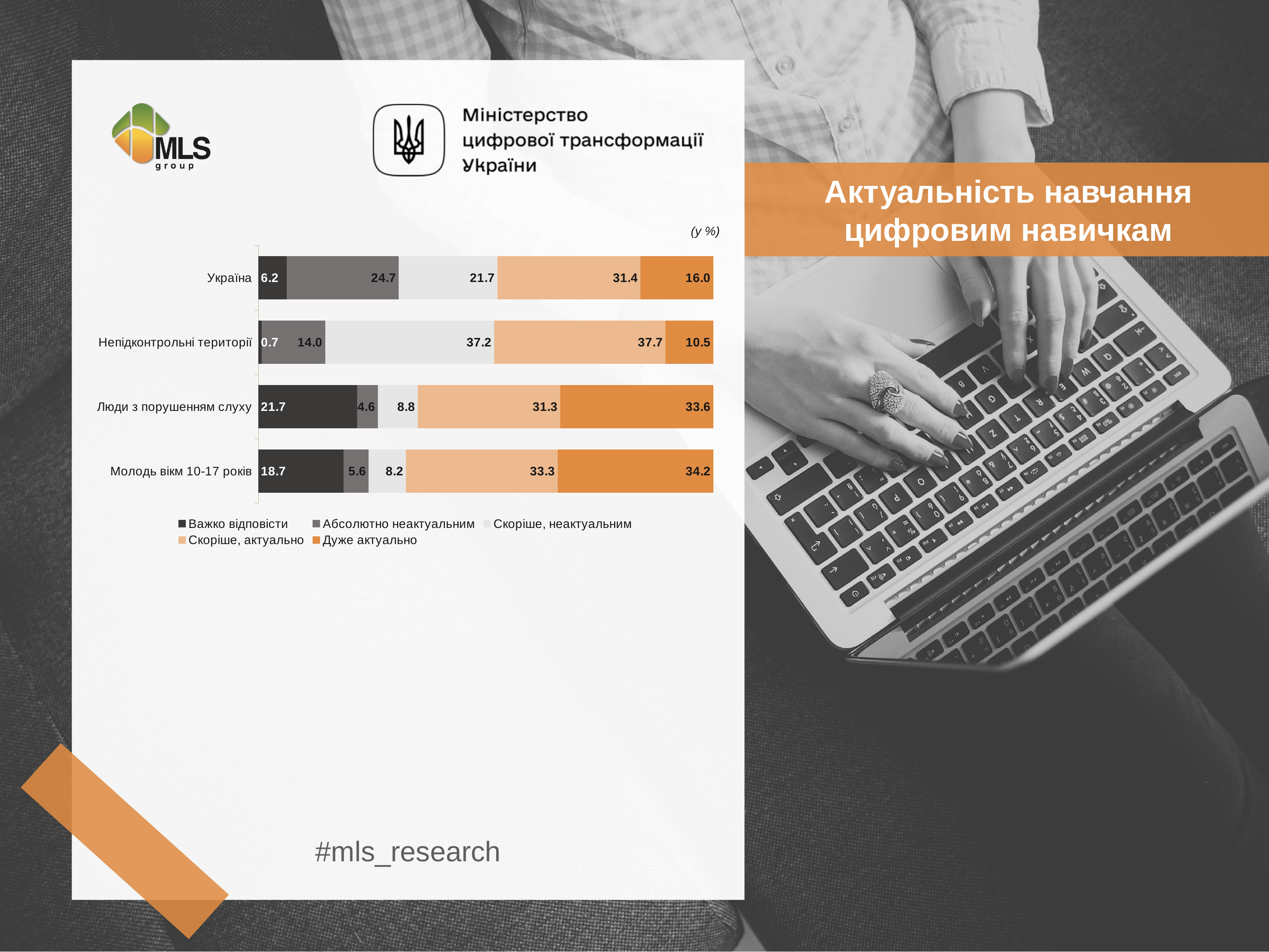
What type of chart is shown on the slide? Stacked bar chart How many categories (groups) are plotted in the chart? 4 Which category has the lowest value for 'Важко відповісти'? Непідконтрольні території Which is larger: 'Скоріше, актуально' for 'Непідконтрольні території' or for 'Україна'? Непідконтрольні території What is the value of 'Скоріше, актуально' for 'Молодь вікм 10-17 років'? 33.3 What is the value of 'Важко відповісти' for 'Люди з порушенням слуху'? 21.7 What is the value of 'Скоріше, неактуальним' for 'Непідконтрольні території'? 37.2 What is the difference between the 'Абсолютно неактуальним' values for 'Україна' and 'Непідконтрольні території'? 10.7 How many series does the legend list? 5 What is the value of 'Дуже актуально' for 'Україна'? 16.0 What is the total of the stacked bar for 'Люди з порушенням слуху'? 100.0 Which category has the highest value for 'Дуже актуально'? Молодь вікм 10-17 років